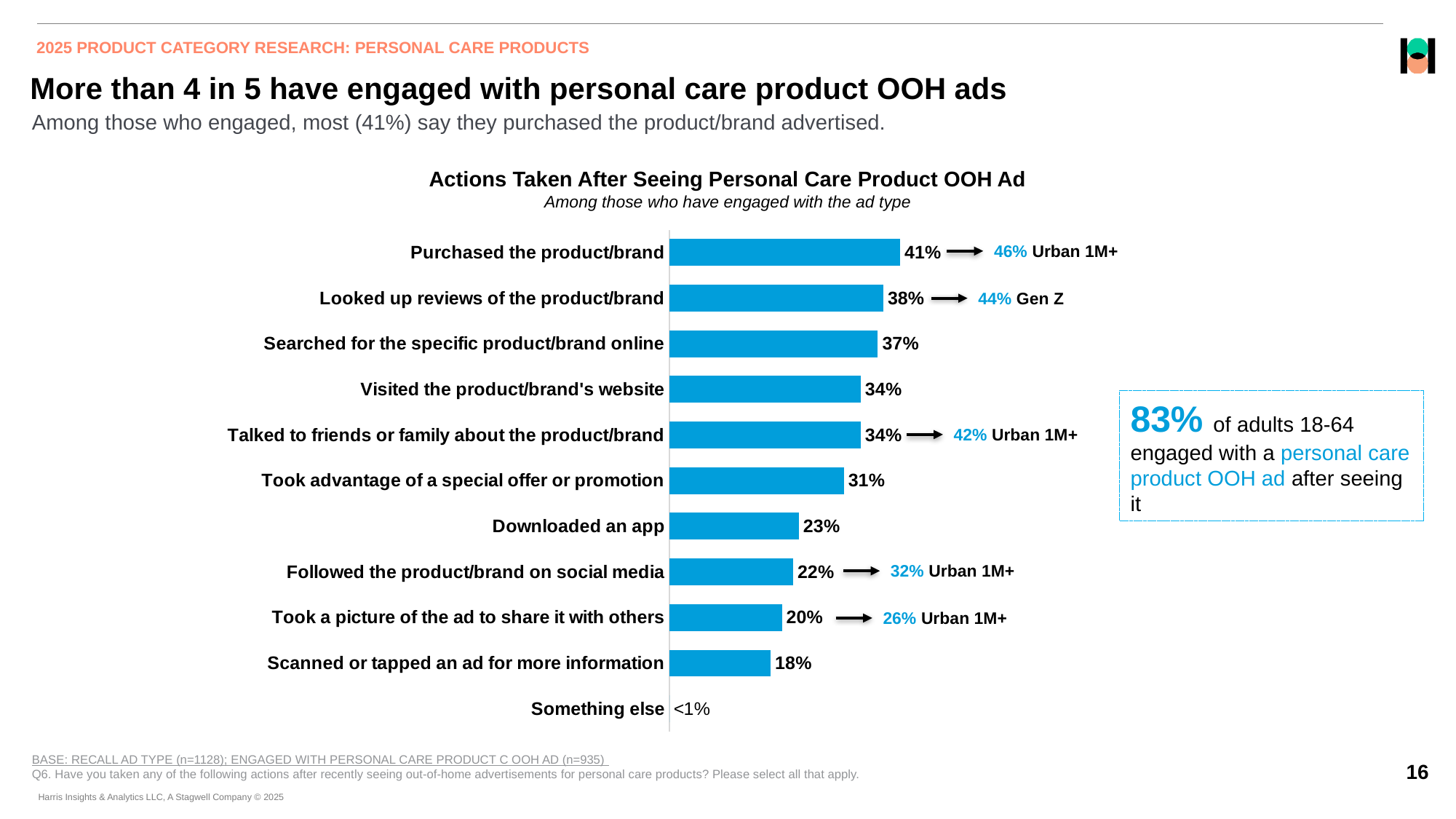
Which action has the lowest percentage in the chart? Something else Which action has the highest percentage in the chart? Purchased the product/brand What kind of chart is shown on the slide? Bar chart What is the title of the chart? Actions Taken After Seeing Personal Care Product OOH Ad Which is larger: 'Searched for the specific product/brand online' or 'Visited the product/brand's website'? Searched for the specific product/brand online What is the difference between 'Took advantage of a special offer or promotion' and 'Downloaded an app'? 8% What is the value for 'Downloaded an app'? 23% What percentage of Urban 1M+ respondents purchased the product/brand, as noted next to the bar? 46% What is the difference between 'Purchased the product/brand' and 'Looked up reviews of the product/brand'? 3% How many action categories are shown in the chart? 11 What is the value for 'Scanned or tapped an ad for more information'? 18% What percentage purchased the product/brand after seeing a personal care product OOH ad? 41%